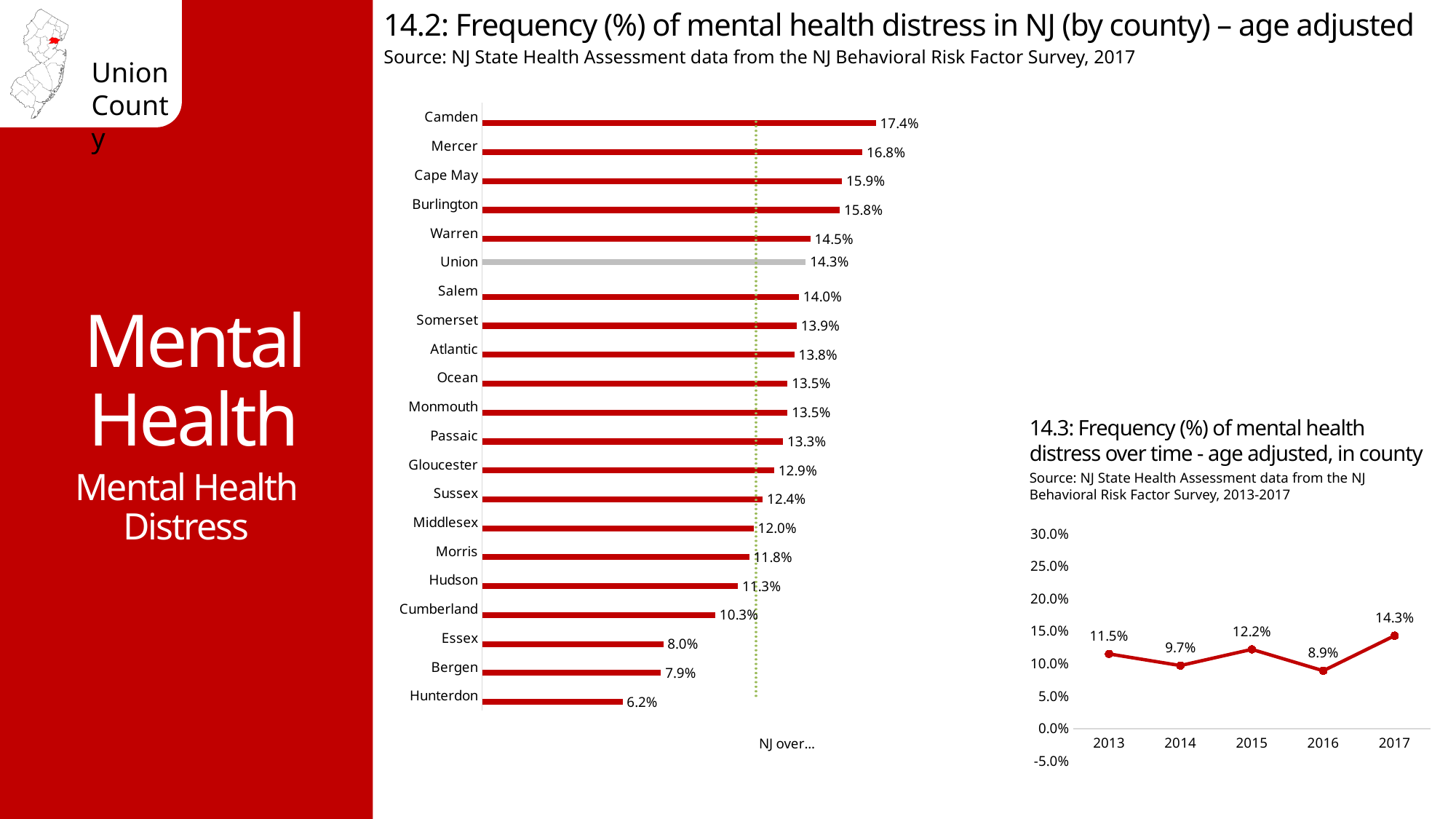
In chart 14.2, which county has a larger value, Mercer or Cape May? Mercer In chart 14.3, which year has the highest value? 2017 In chart 14.2, what is the value for Union county? 14.3% How many counties are shown in chart 14.2? 21 What kind of chart is chart 14.2? Bar chart In chart 14.2, what is the value for Cumberland? 10.3% In chart 14.2, which county has the highest frequency of mental health distress? Camden In chart 14.2, what is the difference between the values for Camden and Hunterdon? 11.2% In chart 14.2, which county has the lowest frequency of mental health distress? Hunterdon In chart 14.3, what is the difference between the values for 2017 and 2013? 2.8% What kind of chart is chart 14.3? Line chart In chart 14.3, what is the value for 2016? 8.9%